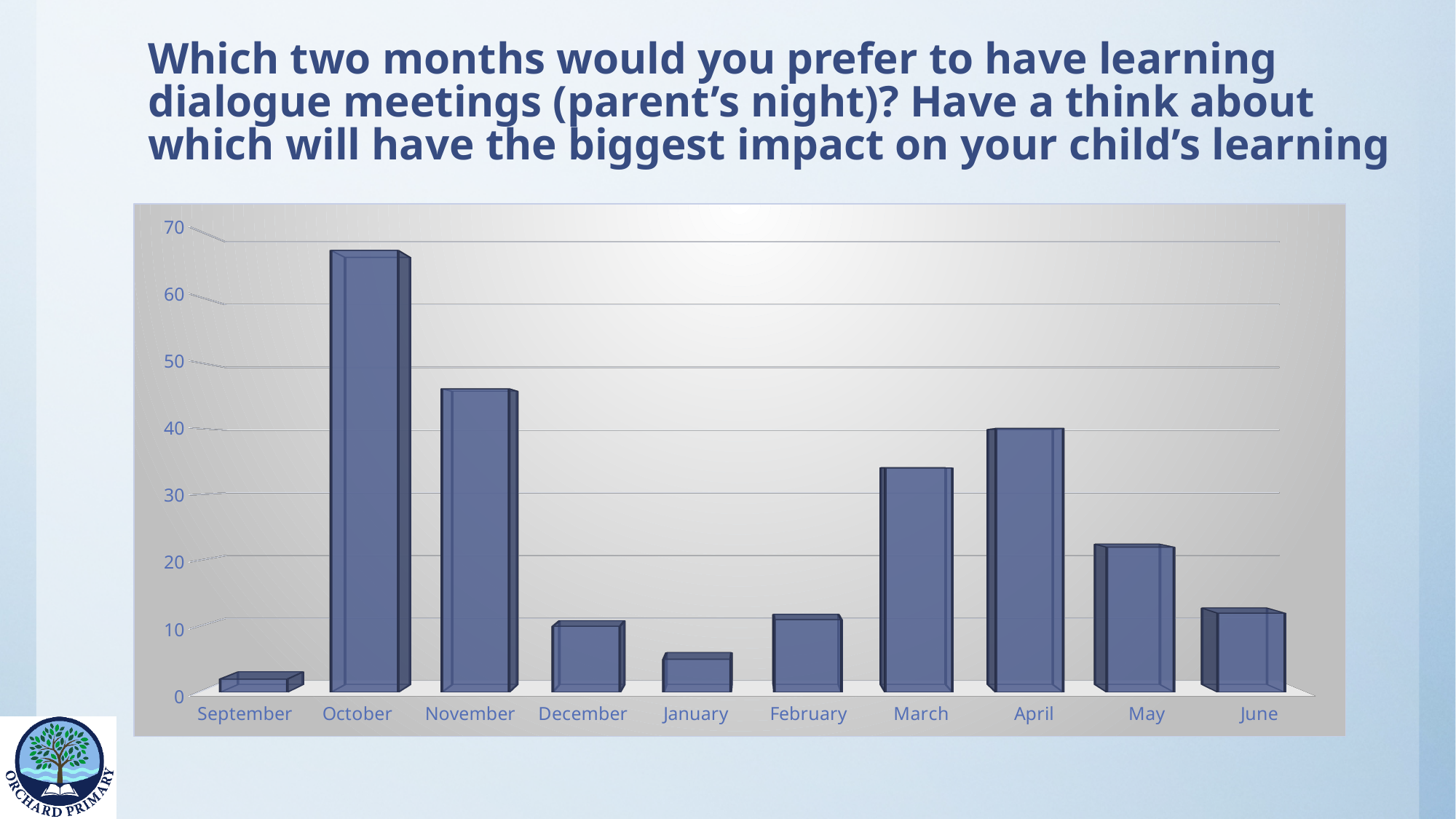
Which month has the lowest bar in the chart? September How many months are shown on the x axis of the chart? 10 Is the value for May greater or less than 30? less Is the value for October greater or less than 60? greater Do the values rise or fall from October to January? fall Is the value for January greater or less than 10? less Which month has the highest bar in the chart? October Which is larger, the value for November or the value for April? November What kind of chart is shown on the slide? bar chart Which is larger, the value for March or the value for May? March